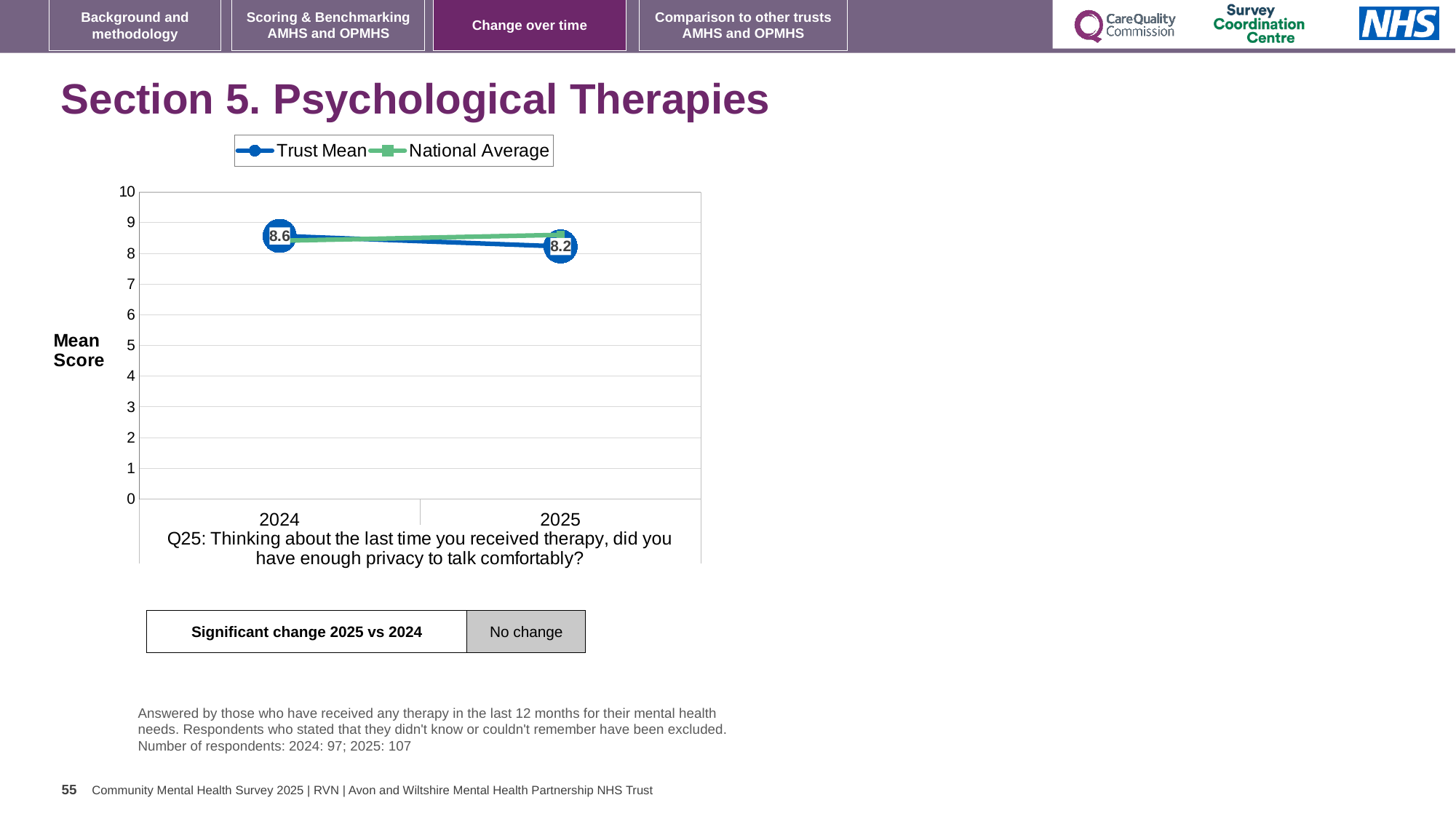
Is the National Average value for 2025 greater or less than 8? greater How many years are shown on the x axis of the chart? 2 In 2025, which is higher, the Trust Mean or the National Average? National Average In which year is the Trust Mean score lowest? 2025 What kind of chart is shown on the slide? line chart In which year is the Trust Mean score highest? 2024 Does the Trust Mean rise or fall from 2024 to 2025? fall What is the difference between the Trust Mean score in 2024 and in 2025? 0.4 How many series does the chart legend list? 2 Which is larger, the Trust Mean score in 2024 or in 2025? 2024 What is the Trust Mean score for 2024? 8.6 What is the Trust Mean score for 2025? 8.2